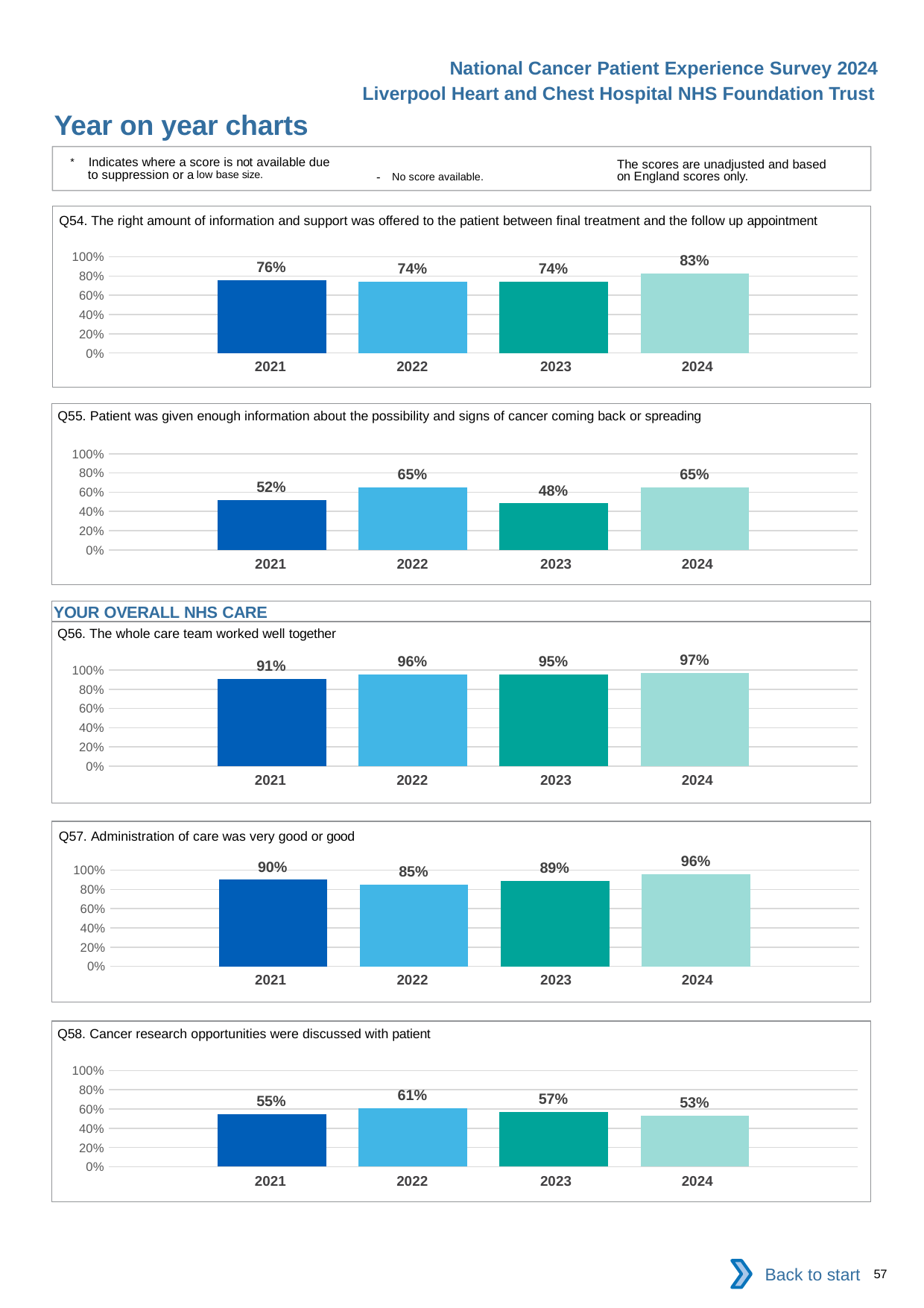
In the Q55 chart, is the value for 2021 larger or smaller than the value for 2022? smaller What kind of chart is the Q56 chart? bar chart What is the section heading shown above the Q56 chart? YOUR OVERALL NHS CARE In the Q54 chart, is the value for 2023 greater or less than 80%? less How many years are shown in the Q54 chart? 4 In the Q58 chart, do the values rise or fall from 2022 to 2024? fall In the Q56 chart, what is the difference between the 2024 and 2021 values? 6% In the Q55 chart, which year has the lowest value? 2023 In the Q57 chart, which year has the highest value? 2024 In the Q58 chart, what is the value for 2022? 61% In the Q54 chart, what is the value for 2024? 83% In the Q57 chart, what is the difference between the 2021 and 2022 values? 5%